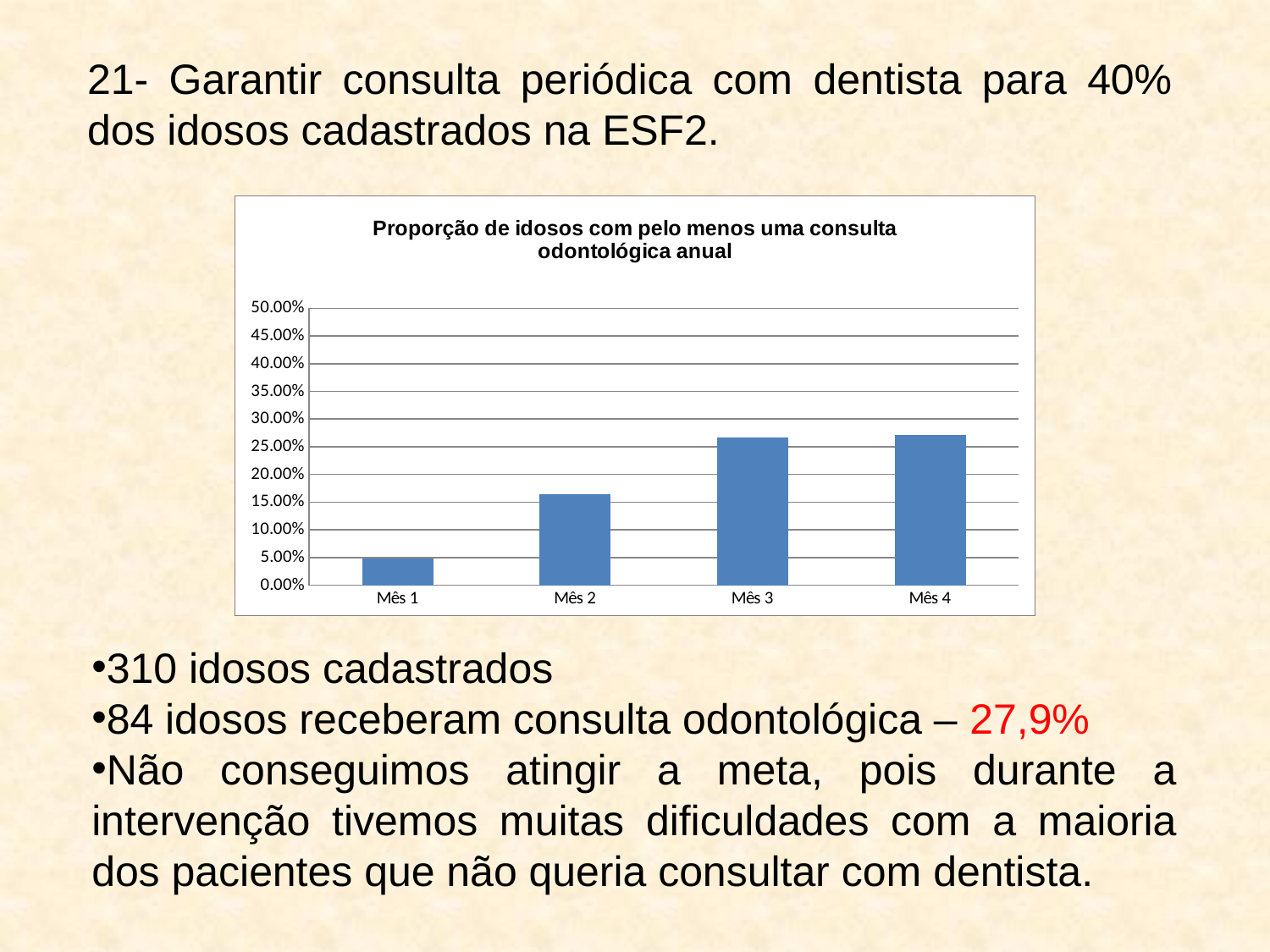
What is the title of the chart? Proporção de idosos com pelo menos uma consulta odontológica anual Is the value for Mês 4 greater or less than 30.00%? less Is the value for Mês 1 greater or less than 10.00%? less Is the value for Mês 3 greater or less than 20.00%? greater What is the highest value shown on the chart's vertical axis? 50.00% Which month has the lowest proportion in the chart? Mês 1 How many months (categories) are plotted on the x axis of the chart? 4 What type of chart is shown on the slide? bar chart Which is larger, the value for Mês 2 or the value for Mês 3? Mês 3 Do the values rise or fall from Mês 1 to Mês 4? rise